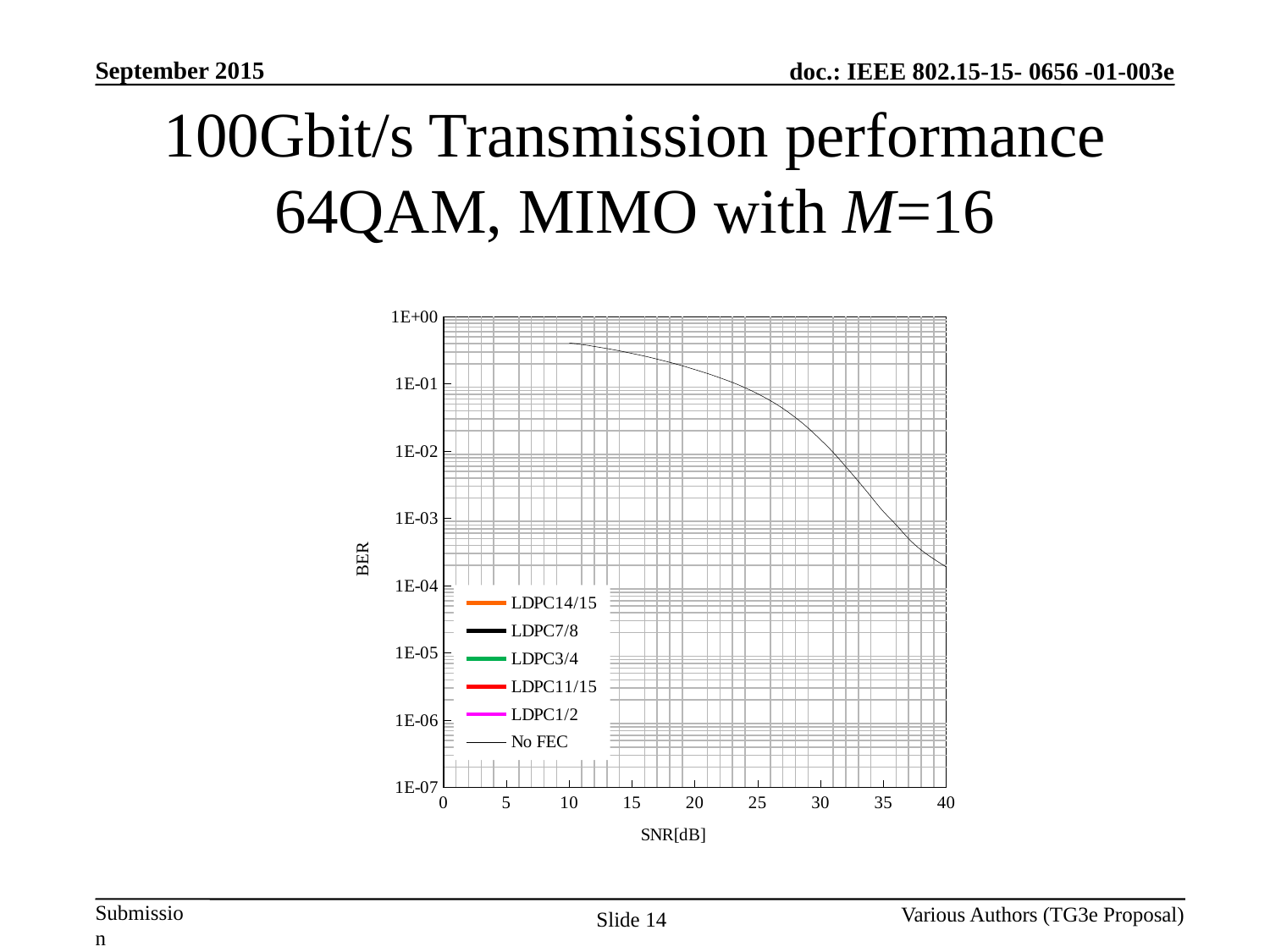
What is the maximum SNR value shown on the x axis? 40 Is the BER of the No FEC curve at SNR 30 dB greater or less than 1E-01? less Which is larger, the BER of the No FEC curve at SNR 20 dB or at SNR 35 dB? SNR 20 dB Is the BER of the No FEC curve at SNR 30 dB greater or less than 1E-02? greater How many series does the legend list? 6 Is the BER of the No FEC curve at SNR 40 dB greater or less than 1E-04? greater What kind of chart is shown on the slide? line chart What is the label of the x axis? SNR[dB] Does the No FEC curve rise or fall as SNR increases? fall What is the label of the y axis? BER